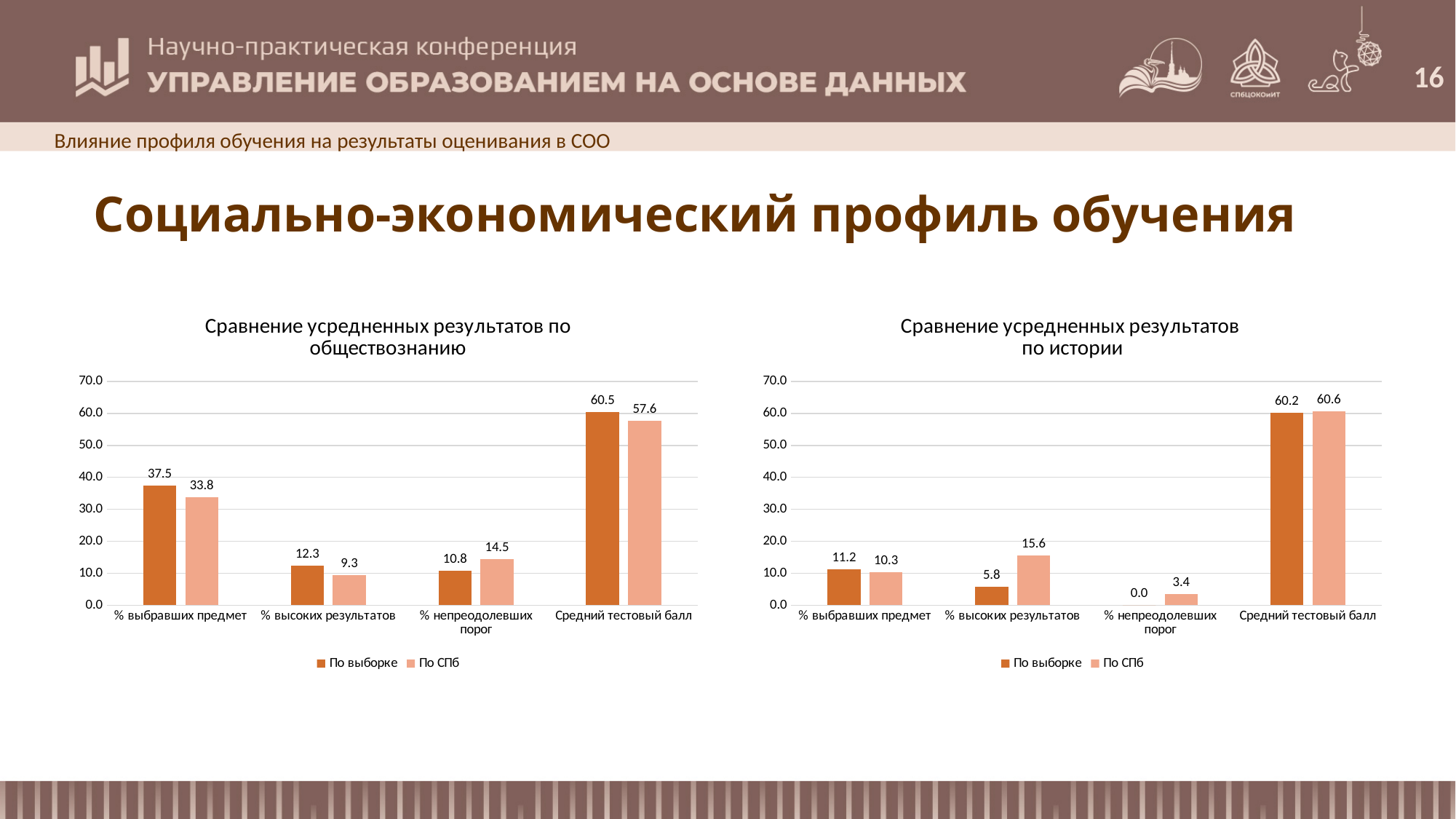
In the chart 'Сравнение усредненных результатов по обществознанию', what is the difference between 'По выборке' and 'По СПб' for 'Средний тестовый балл'? 2.9 What type of chart is 'Сравнение усредненных результатов по истории'? Bar chart How many series does the legend of the chart 'Сравнение усредненных результатов по обществознанию' list? 2 In the chart 'Сравнение усредненных результатов по обществознанию', what is the value of 'По СПб' for '% непреодолевших порог'? 14.5 How many categories are shown on the x axis of the chart 'Сравнение усредненных результатов по истории'? 4 In the chart 'Сравнение усредненных результатов по обществознанию', what is the value of 'По выборке' for '% выбравших предмет'? 37.5 In the chart 'Сравнение усредненных результатов по истории', what is the value of 'По СПб' for '% высоких результатов'? 15.6 In the chart 'Сравнение усредненных результатов по обществознанию', which is larger for '% высоких результатов': 'По выборке' or 'По СПб'? По выборке In the chart 'Сравнение усредненных результатов по обществознанию', which category has the highest value for 'По выборке'? Средний тестовый балл In the chart 'Сравнение усредненных результатов по истории', what is the value of 'По выборке' for '% непреодолевших порог'? 0.0 In the chart 'Сравнение усредненных результатов по истории', which category has the lowest value for 'По СПб'? % непреодолевших порог In the chart 'Сравнение усредненных результатов по истории', what is the difference between 'По СПб' and 'По выборке' for '% высоких результатов'? 9.8